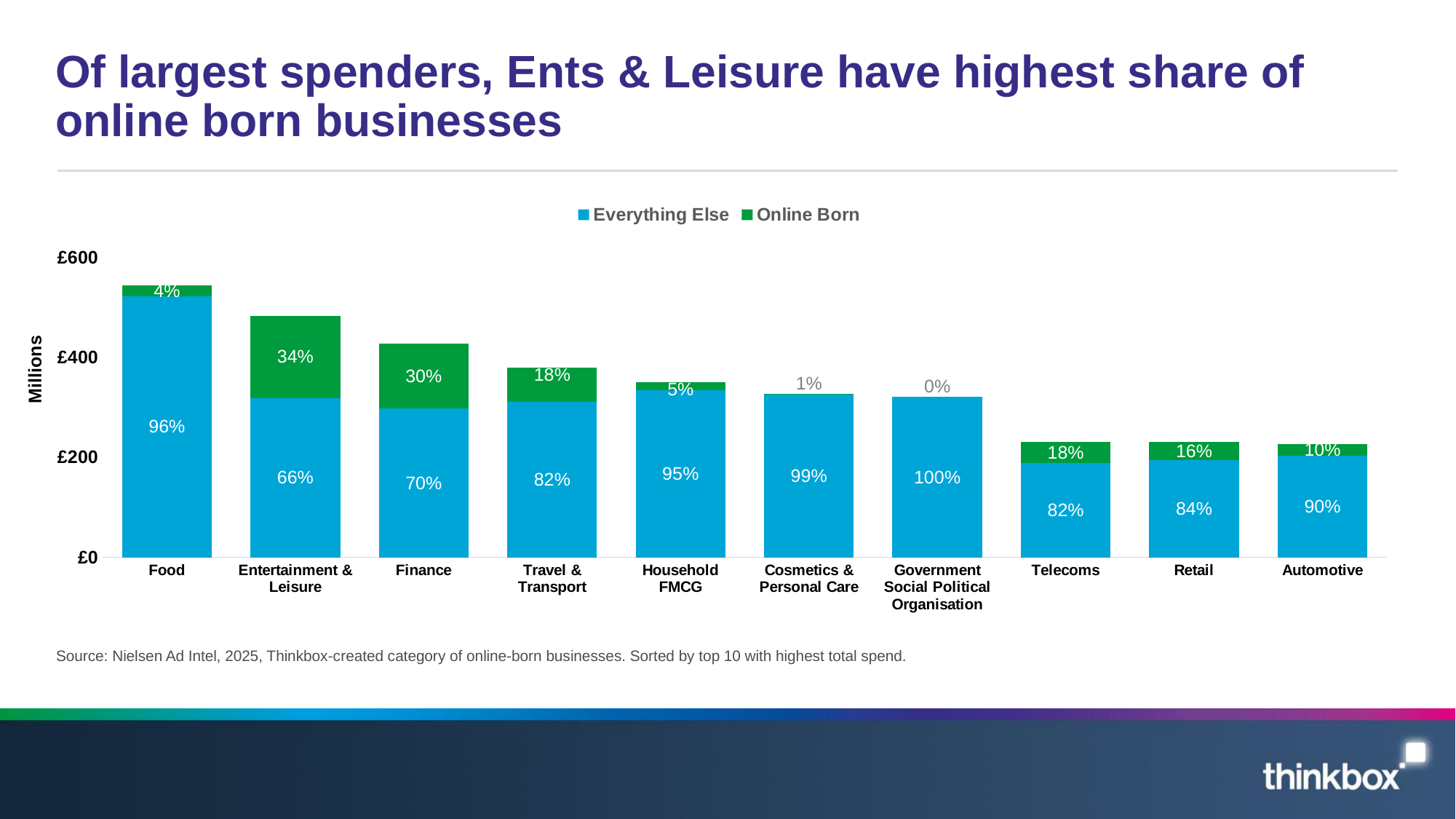
What is the Everything Else share shown for Automotive? 90% How many categories are shown on the x axis? 10 How many series does the legend list? 2 Which category has the lowest Online Born share? Government Social Political Organisation Is the total bar for Food greater or less than £400 million? greater Which category has the highest Online Born share? Entertainment & Leisure What is the Online Born share shown for Entertainment & Leisure? 34% Which has the larger Online Born share, Retail or Telecoms? Telecoms Is the total bar for Telecoms greater or less than £400 million? less What is the Everything Else share shown for Finance? 70% How many percentage points higher is the Online Born share for Finance than for Travel & Transport? 12 percentage points What is the Online Born share shown for Telecoms? 18%